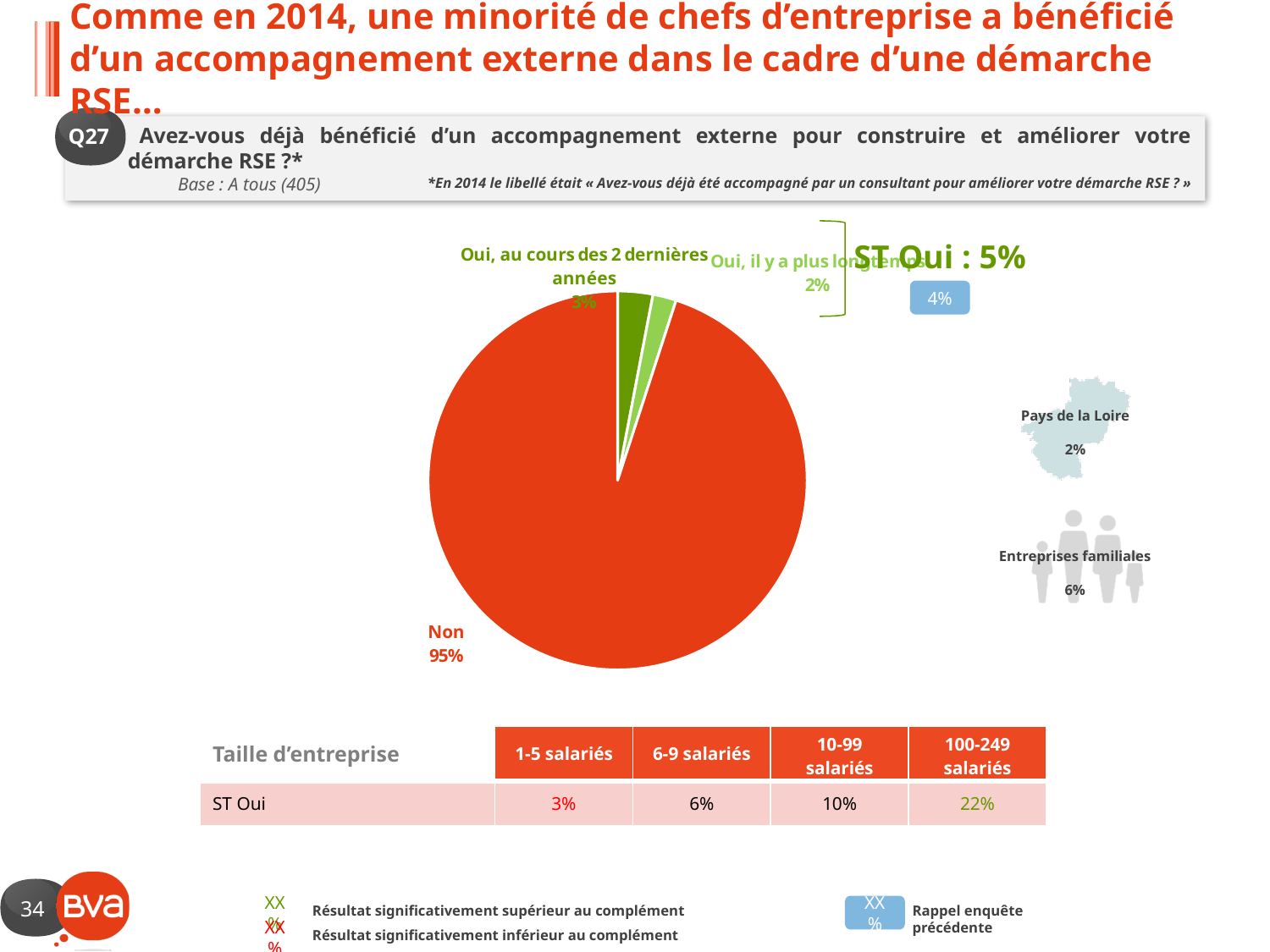
What is the 'ST Oui' value shown next to the pie chart? 5% What type of chart is shown on the slide? pie chart Which slice of the pie chart is the smallest? Oui, il y a plus longtemps What is the value of the 'Oui, il y a plus longtemps' slice in the pie chart? 2% What is the value of the 'Non' slice in the pie chart? 95% Which is larger in the pie chart: 'Oui, au cours des 2 dernières années' or 'Oui, il y a plus longtemps'? Oui, au cours des 2 dernières années What is the value of the 'Oui, au cours des 2 dernières années' slice in the pie chart? 3% What is the difference between the 'Non' slice and the 'Oui, il y a plus longtemps' slice in the pie chart? 93 percentage points Which slice of the pie chart is the largest? Non How many slices does the pie chart have? 3 What colour is the 'Non' slice of the pie chart? red What is the combined share of the two 'Oui' slices in the pie chart? 5%